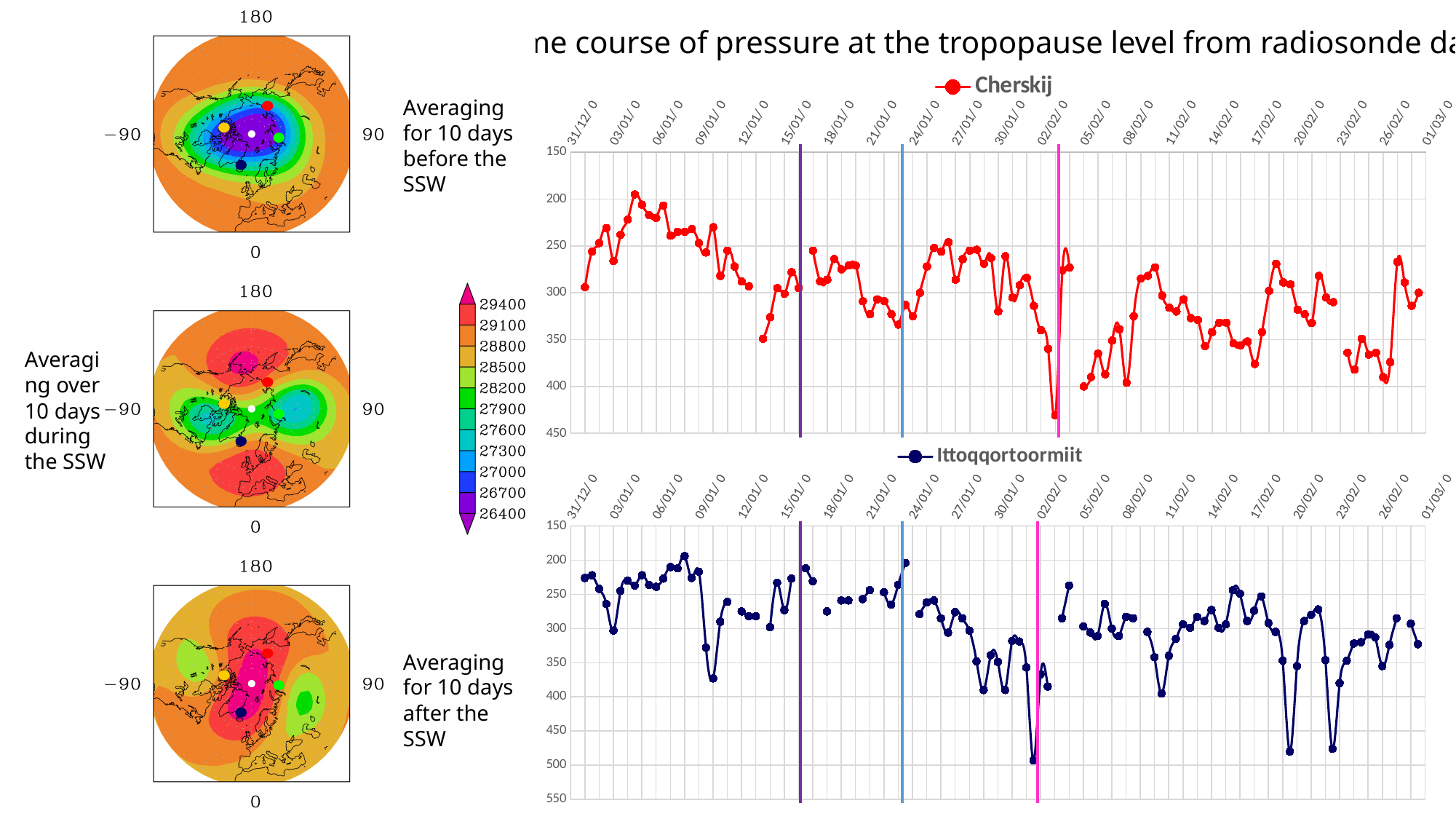
In the Cherskij chart, is the peak value reached just before 02/02 greater or less than 400? greater What kind of chart is the Cherskij chart? line chart In the Ittoqqortoormiit chart, is the value around 06/01 greater or less than 250? less Which chart reaches a larger maximum value, Cherskij or Ittoqqortoormiit? Ittoqqortoormiit In the Cherskij chart, what is the largest value shown on the vertical axis? 450 In the Cherskij chart, is the value around 09/01 greater or less than 350? less In the Ittoqqortoormiit chart, what is the largest value shown on the vertical axis? 550 How many series does the legend of the Ittoqqortoormiit chart list? 1